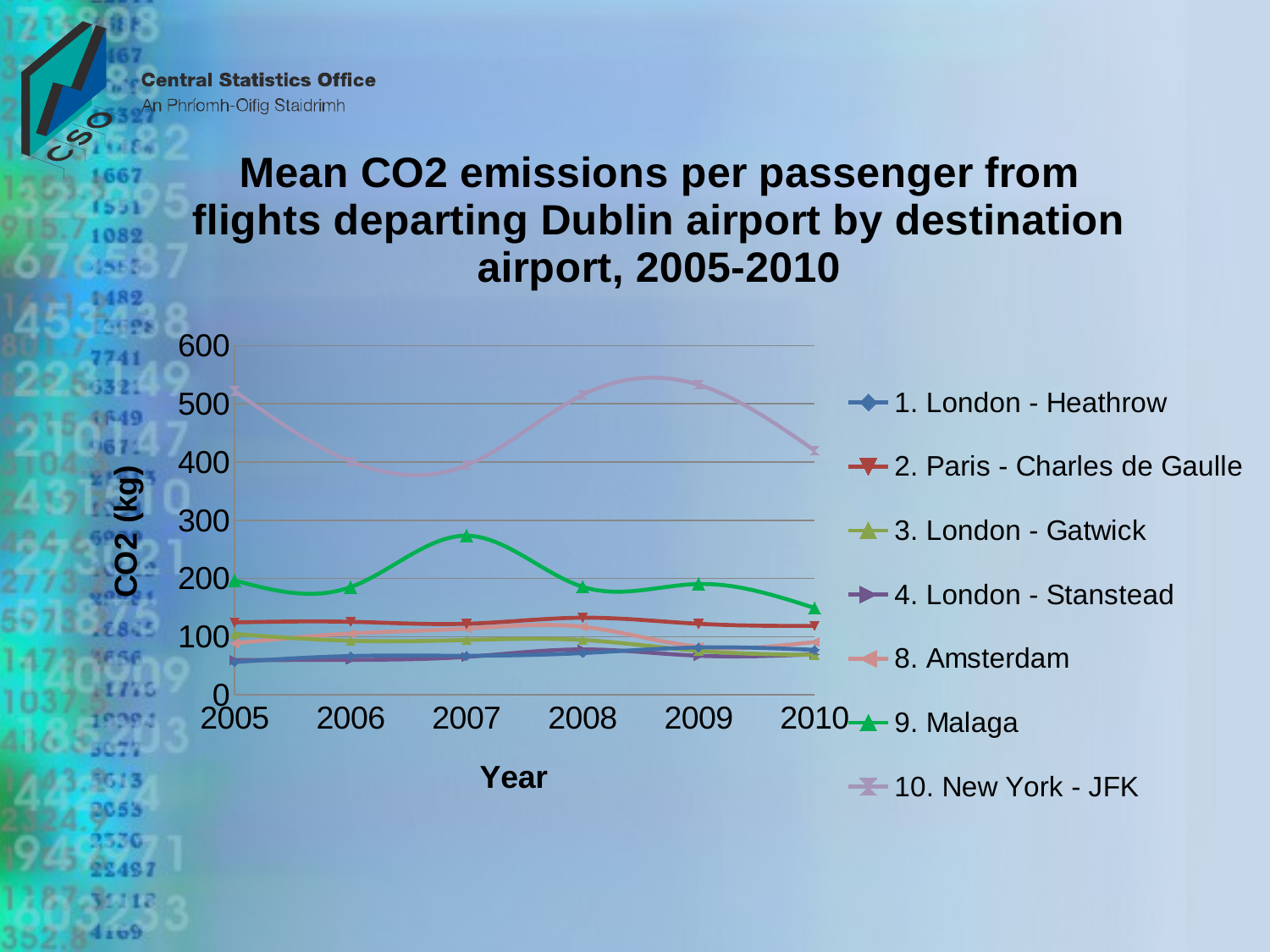
What is the label on the y axis? CO2 (kg) Which destination airport has the highest mean CO2 emissions per passenger across all years? 10. New York - JFK Is the value for New York - JFK in 2005 greater or less than 500? greater Is the value for New York - JFK in 2010 greater or less than 500? less Is the value for Malaga in 2007 greater or less than 200? greater What kind of chart is shown on the slide? Line chart In 2007, which has the higher mean CO2 emissions per passenger: Malaga or Paris - Charles de Gaulle? 9. Malaga What is the label on the x axis? Year How many destination airports does the legend list? 7 Does the value for New York - JFK rise or fall from 2009 to 2010? Fall How many years are plotted along the x axis? 6